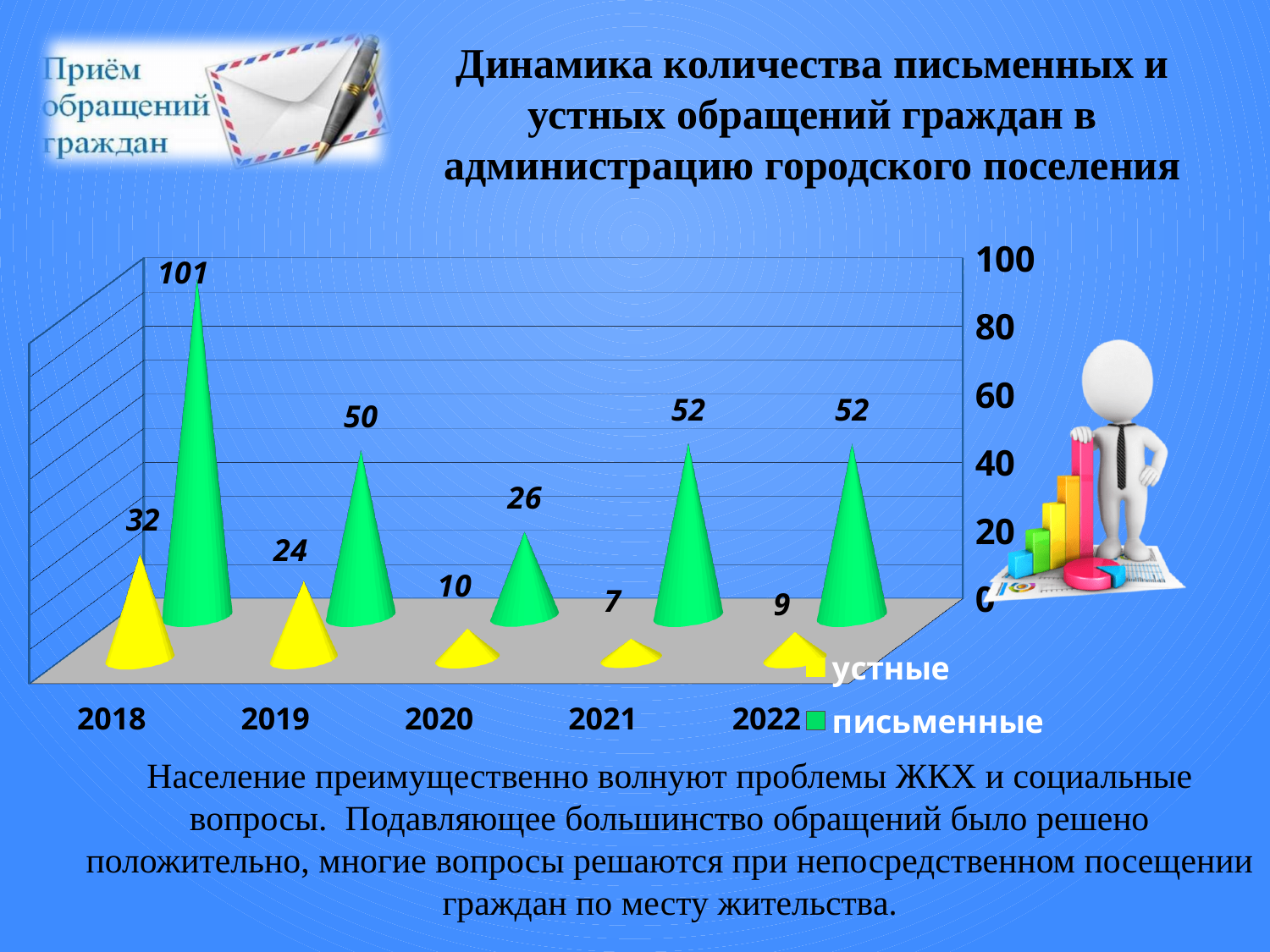
What is the value for письменные in 2018? 101 How many years are shown on the x axis? 5 In which year is the value for устные the lowest? 2021 What is the difference between письменные and устные in 2019? 26 What is the value for устные in 2020? 10 Which colour represents the письменные series? green What kind of chart is shown on the slide? bar chart In which year is the value for письменные the highest? 2018 How many series does the legend list? 2 Which is larger in 2022: письменные or устные? письменные Do the values for устные rise or fall from 2018 to 2021? fall What is the value for устные in 2021? 7